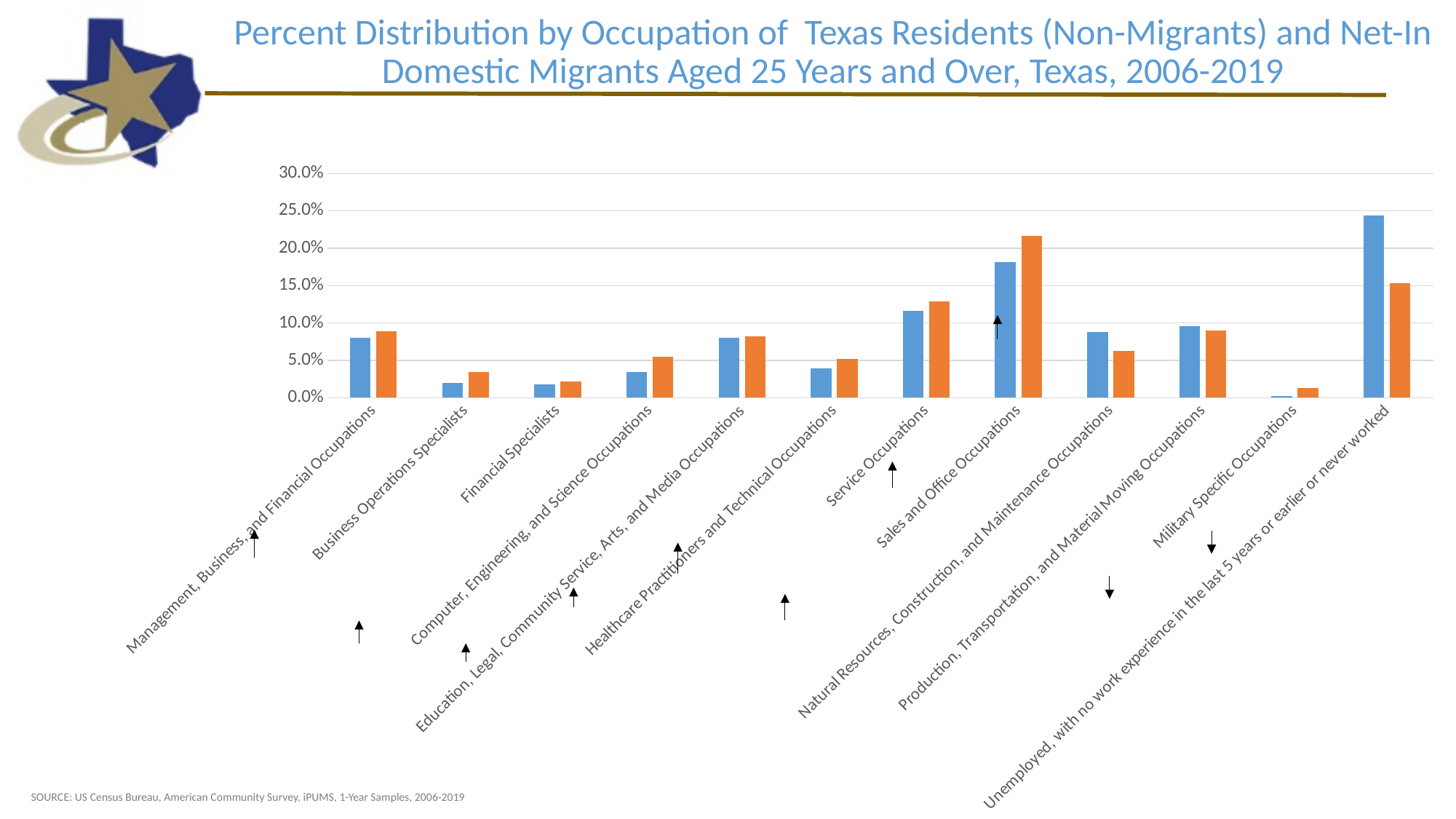
Which category has the shortest blue bar? Military Specific Occupations Which category has the tallest blue bar? Unemployed, with no work experience in the last 5 years or earlier or never worked How many occupation categories are shown on the x axis? 12 Which category has the tallest orange bar? Sales and Office Occupations For Sales and Office Occupations, which bar is taller, the blue or the orange? orange For Natural Resources, Construction, and Maintenance Occupations, which bar is taller, the blue or the orange? blue Is the orange bar for Unemployed, with no work experience in the last 5 years or earlier or never worked greater or less than 20.0%? less Is the blue bar for Sales and Office Occupations greater or less than 15.0%? greater Which category has the shortest orange bar? Military Specific Occupations Is the orange bar for Computer, Engineering, and Science Occupations greater or less than 10.0%? less What is the highest value shown on the y axis? 30.0% What type of chart is shown on the slide? bar chart